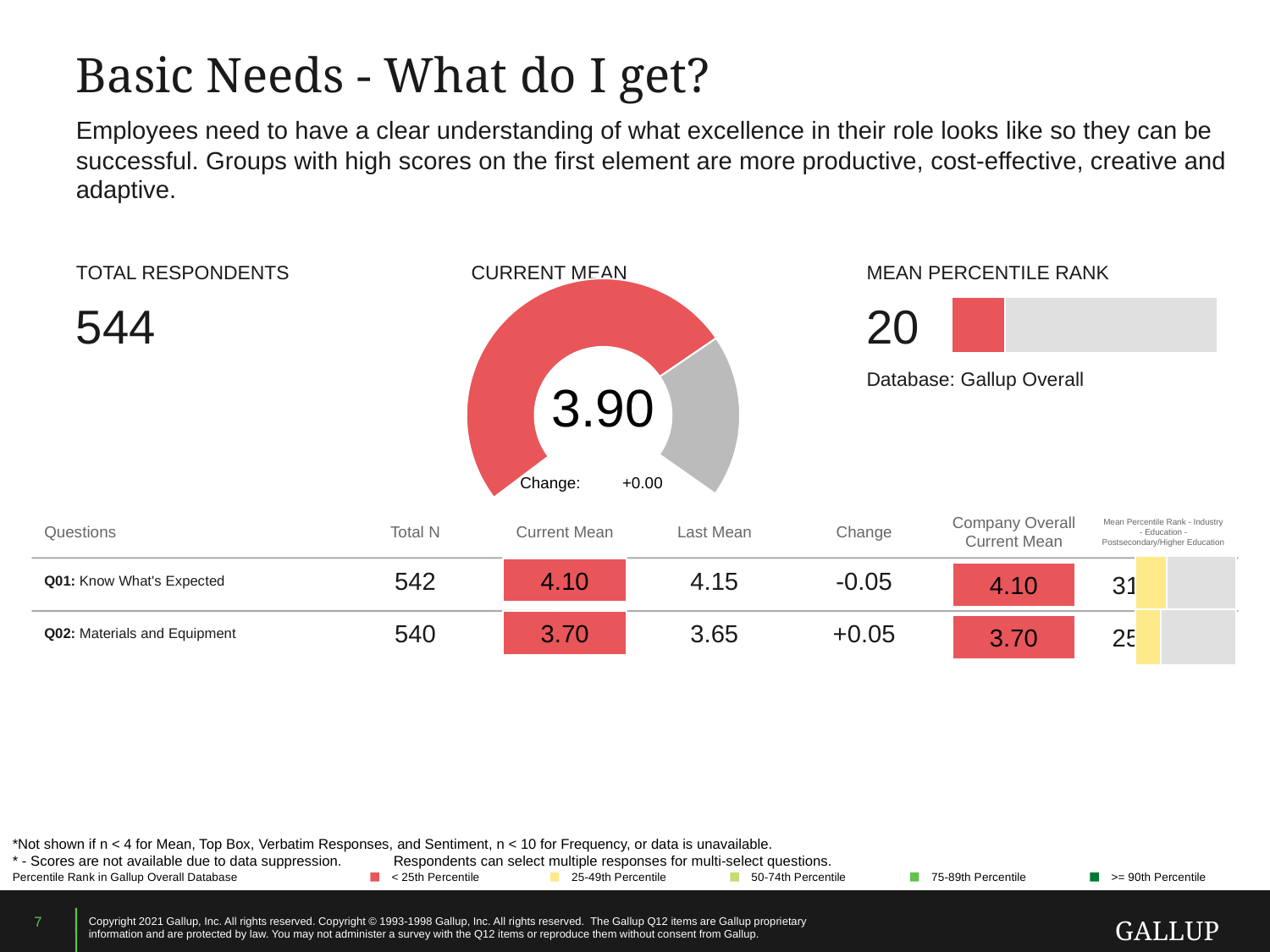
In the Mean Percentile Rank bar at the top right, is the filled portion greater or less than half of the bar? less What is the Total Respondents figure shown on the slide? 544 What is the value shown in the centre of the Current Mean gauge chart? 3.90 How many questions are listed in the table on the slide? 2 In the questions table, what is the Last Mean for Q02: Materials and Equipment? 3.65 In the questions table, what is the difference between the Current Mean of Q01 and the Current Mean of Q02? 0.40 In the questions table, which question has the higher Current Mean, Q01 or Q02? Q01: Know What's Expected What is the Mean Percentile Rank value shown next to the horizontal bar at the top right? 20 What change value is shown below the Current Mean gauge chart? +0.00 What database is named below the Mean Percentile Rank bar? Gallup Overall In the questions table, what is the Change value for Q01: Know What's Expected? -0.05 In the questions table, what is the Current Mean for Q01: Know What's Expected? 4.10